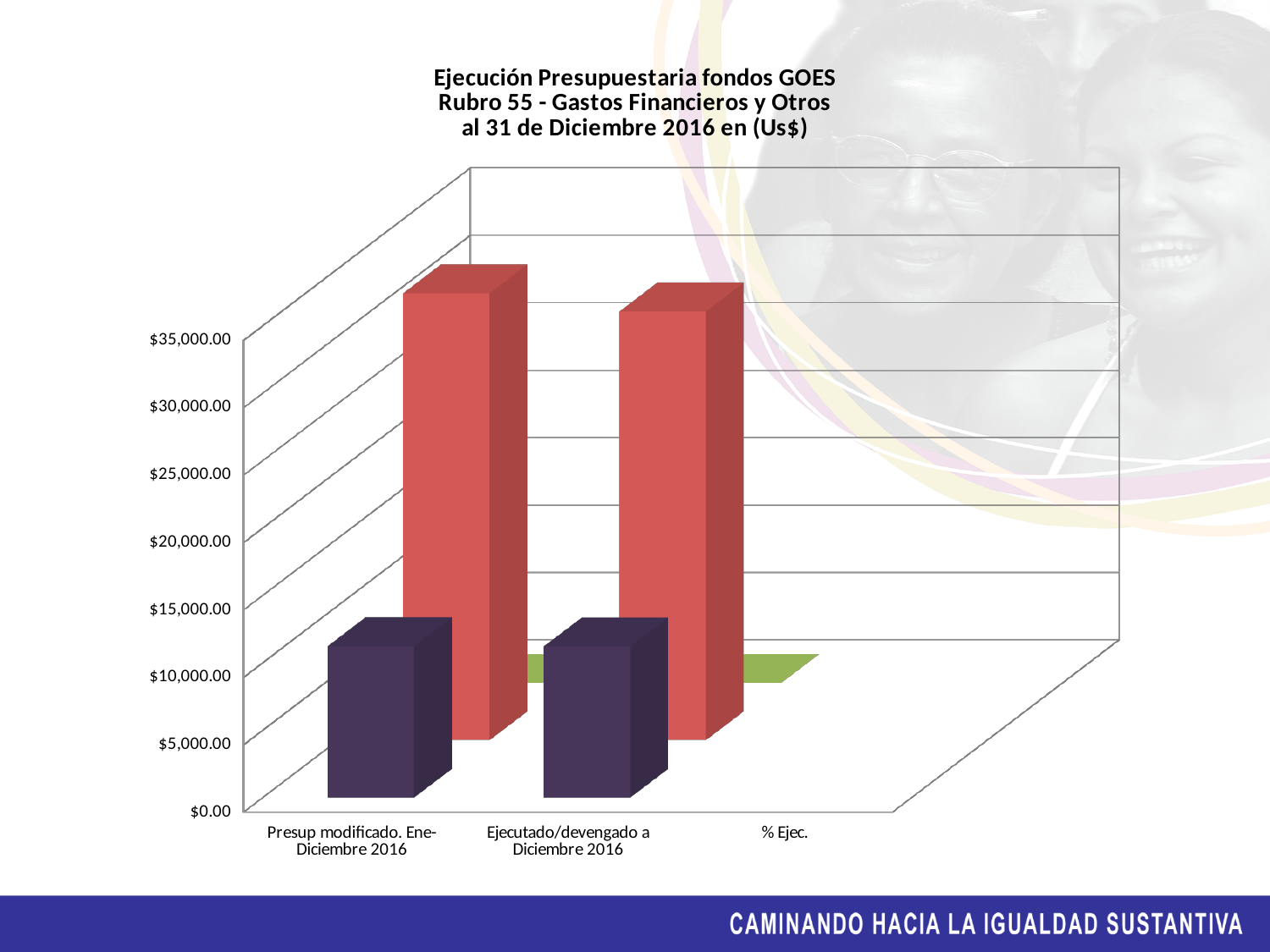
Which category on the x axis has the lowest values? % Ejec. How many categories are shown on the x axis of the chart? 3 Is the value of the red bar for "Ejecutado/devengado a Diciembre 2016" greater or less than $20,000.00? greater For "Presup modificado. Ene-Diciembre 2016", which bar is larger, the red one or the purple one? the red one Is the value of the purple bar for "Ejecutado/devengado a Diciembre 2016" greater or less than $5,000.00? greater Is the value for "% Ejec." greater or less than $5,000.00? less What kind of chart is shown on the slide? bar chart What is the title of the chart? Ejecución Presupuestaria fondos GOES Rubro 55 - Gastos Financieros y Otros al 31 de Diciembre 2016 en (Us$) What is the label of the third category on the x axis? % Ejec.